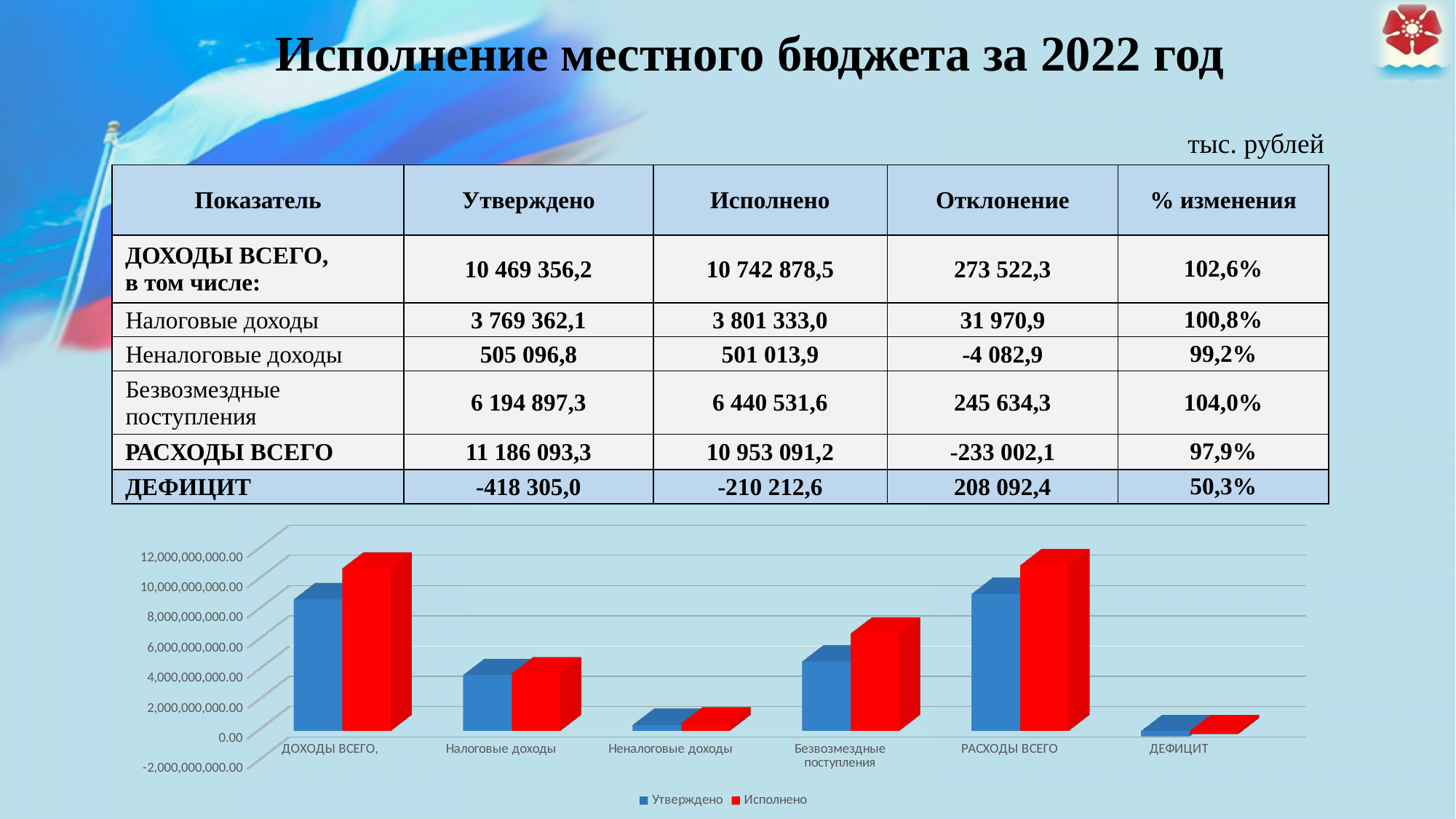
What kind of chart is shown at the bottom of the slide? bar chart In the chart, which is larger for the Исполнено series: Налоговые доходы or Безвозмездные поступления? Безвозмездные поступления In the chart, is the Утверждено value for ДОХОДЫ ВСЕГО greater or less than 8,000,000,000.00? greater In the chart, is the Исполнено value for Неналоговые доходы greater or less than 2,000,000,000.00? less Which category has the lowest bars in the chart? ДЕФИЦИТ What are the two series named in the chart legend? Утверждено and Исполнено In the chart, is the Исполнено value for Безвозмездные поступления greater or less than 4,000,000,000.00? greater How many series does the chart legend list? 2 How many categories are shown on the x axis of the chart? 6 Which colour represents the Исполнено series in the chart? red In the chart, which is larger for the Утверждено series: Неналоговые доходы or Налоговые доходы? Налоговые доходы